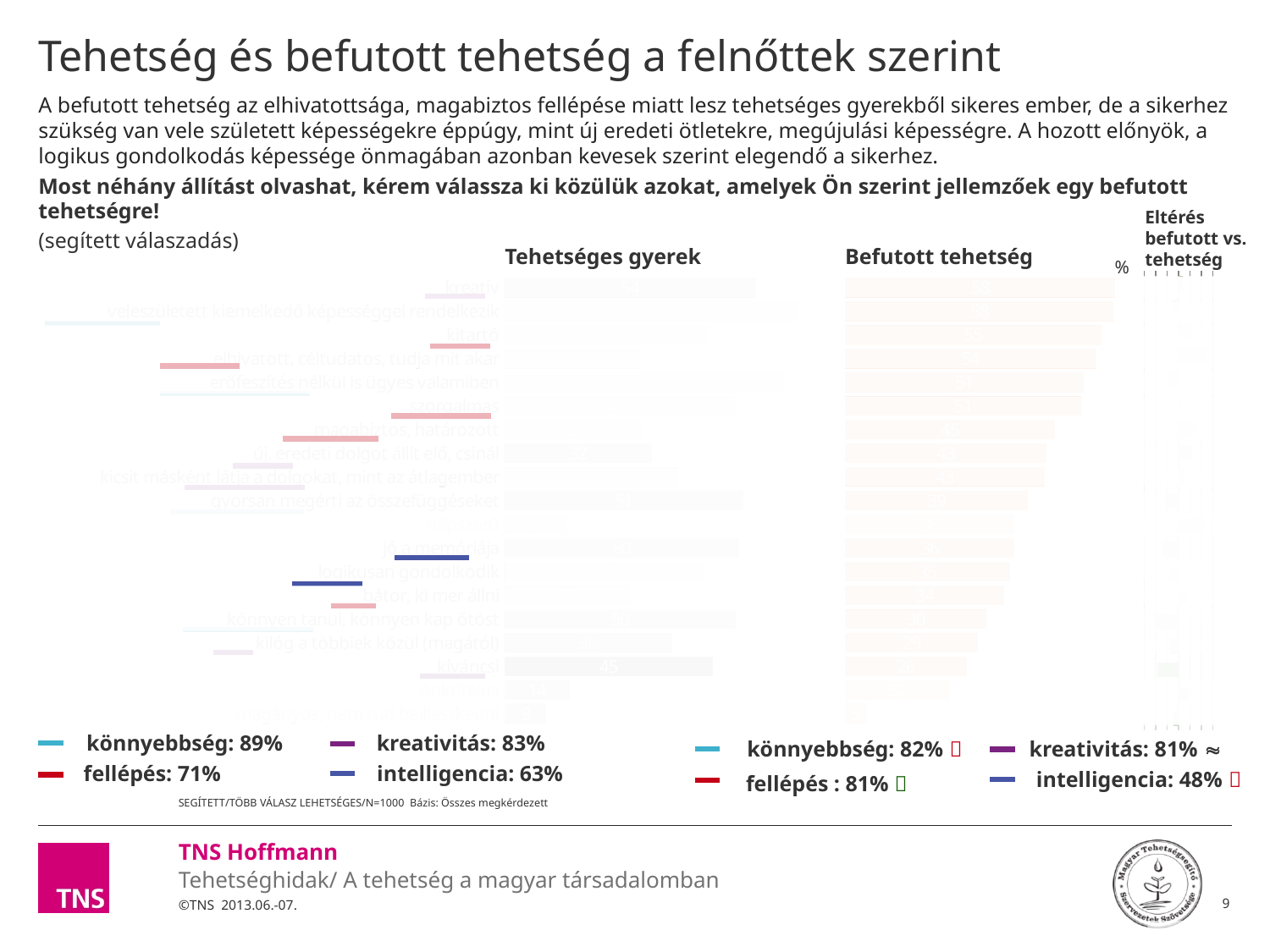
Is the intelligencia summary percentage higher for Tehetséges gyerek or for Befutott tehetség? Tehetséges gyerek What is the difference between the könnyebbség summary percentages for Tehetséges gyerek (89%) and Befutott tehetség (82%)? 7 percentage points What is the heading of the narrow column to the right of the Befutott tehetség chart? Eltérés befutott vs. tehetség Which of the four summary groups has the highest percentage for the Tehetséges gyerek chart? könnyebbség (89%) In the Tehetséges gyerek chart, what percentage is given for könnyebbség in the summary below the chart? 89% Is the kreativitás summary percentage higher for Tehetséges gyerek or for Befutott tehetség? Tehetséges gyerek In the Befutott tehetség chart, what percentage is given for fellépés in the summary below the chart? 81% What kind of chart is used on this slide to show the statements about talented children and successful talents? bar chart Which of the four summary groups has the lowest percentage for the Befutott tehetség chart? intelligencia (48%) What are the titles of the two chart panels on the slide? Tehetséges gyerek and Befutott tehetség What is the difference between the intelligencia summary percentages for Tehetséges gyerek (63%) and Befutott tehetség (48%)? 15 percentage points In the Befutott tehetség chart, what percentage is given for intelligencia in the summary below the chart? 48%